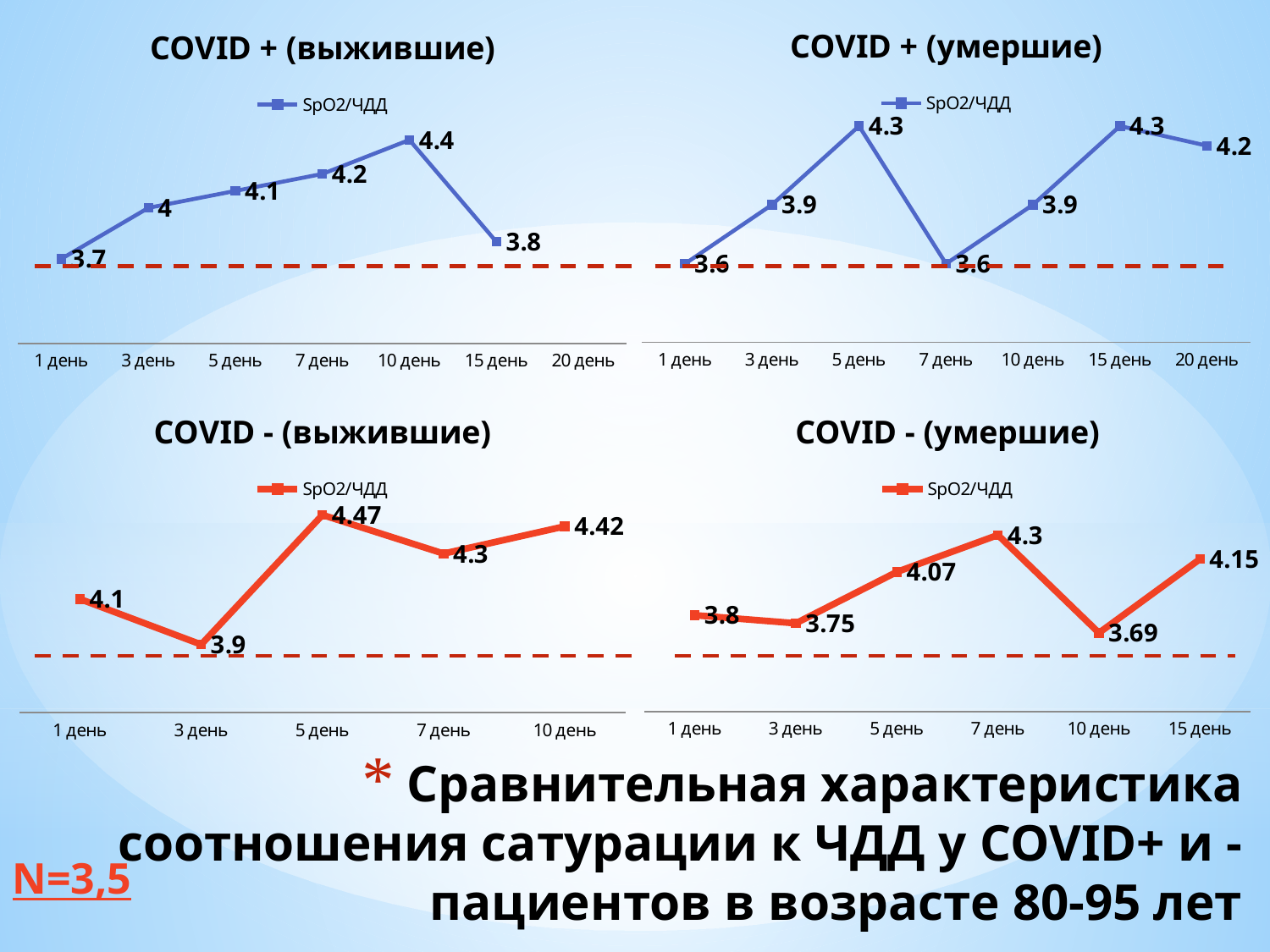
In the "COVID - (умершие)" chart, which is larger: the value on 5 день or on 15 день? 15 день In the "COVID - (умершие)" chart, which day has the highest value? 7 день In the "COVID - (выжившие)" chart, which day has the highest value? 5 день In the "COVID - (выжившие)" chart, which day has the lowest value? 3 день In the "COVID + (выжившие)" chart, what is the value on 1 день? 3.7 In the "COVID + (выжившие)" chart, what is the SpO2/ЧДД value on 10 день? 4.4 In the "COVID - (умершие)" chart, what is the value on 10 день? 3.69 What series name does the legend show in the "COVID - (выжившие)" chart? SpO2/ЧДД In the "COVID + (умершие)" chart, what is the value on 20 день? 4.2 How many data points are plotted in the "COVID - (умершие)" chart? 6 In the "COVID + (умершие)" chart, what is the difference between the values on 5 день and 7 день? 0.7 What type of chart is "COVID + (умершие)"? Line chart